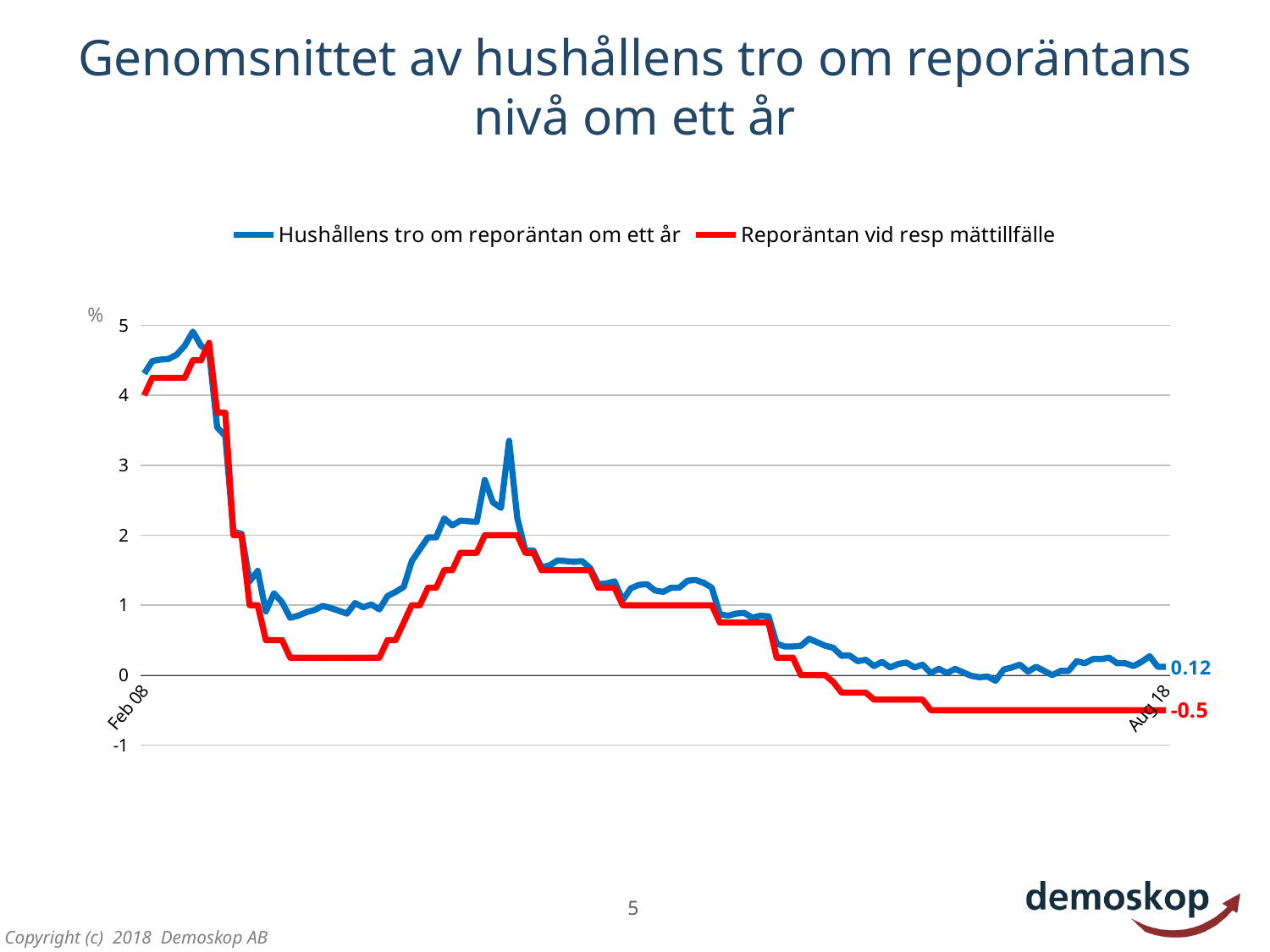
What is the value of 'Hushållens tro om reporäntan om ett år' at Aug 18? 0.12 At Aug 18, which series has the higher value? Hushållens tro om reporäntan om ett år Is the value of 'Reporäntan vid resp mättillfälle' at Feb 08 greater or less than 3? greater What kind of chart is shown on the slide? line chart What colour is the line for 'Reporäntan vid resp mättillfälle'? red Do the values of 'Reporäntan vid resp mättillfälle' rise or fall overall from Feb 08 to Aug 18? fall What is the value of 'Reporäntan vid resp mättillfälle' at Aug 18? -0.5 Is the highest value reached by 'Hushållens tro om reporäntan om ett år' greater or less than 4? greater What is the title of the chart? Genomsnittet av hushållens tro om reporäntans nivå om ett år What is the difference between the two series' values at Aug 18? 0.62 How many series does the legend list? 2 Is the value of 'Hushållens tro om reporäntan om ett år' at Feb 08 greater or less than 4? greater